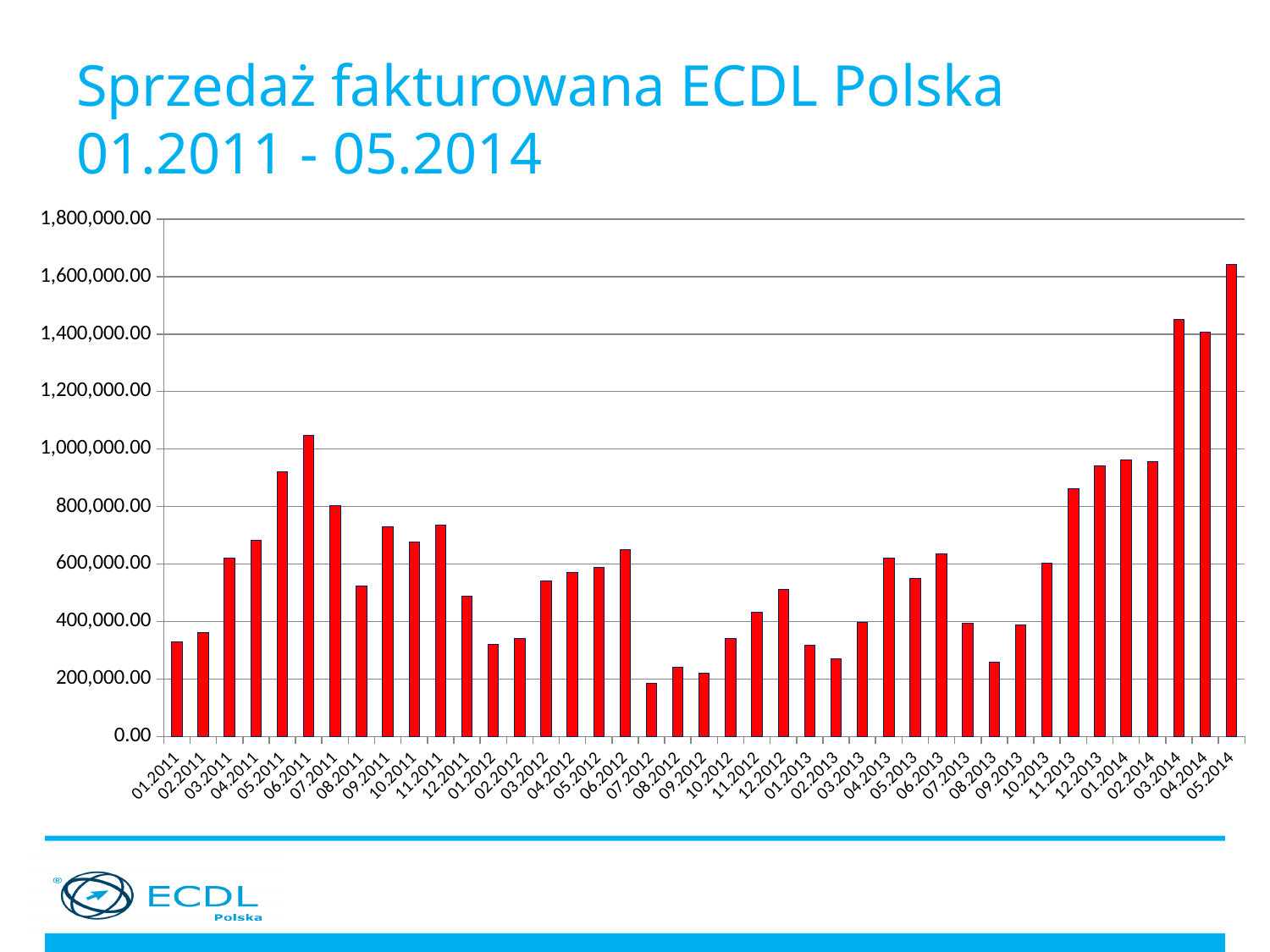
What kind of chart is shown on the slide? bar chart Is the value for 05.2014 greater or less than 1,600,000.00? greater Do the values rise or fall from 10.2012 to 12.2012? rise Is the value for 06.2011 greater or less than 800,000.00? greater Which month has the lowest value on the chart? 07.2012 Is the value for 03.2014 greater or less than 1,200,000.00? greater Which is larger, the value for 12.2011 or the value for 01.2012? 12.2011 What colour are the bars on the chart? red Which is larger, the value for 05.2011 or the value for 06.2011? 06.2011 How many months (bars) are plotted on the chart? 41 Which month has the highest value on the chart? 05.2014